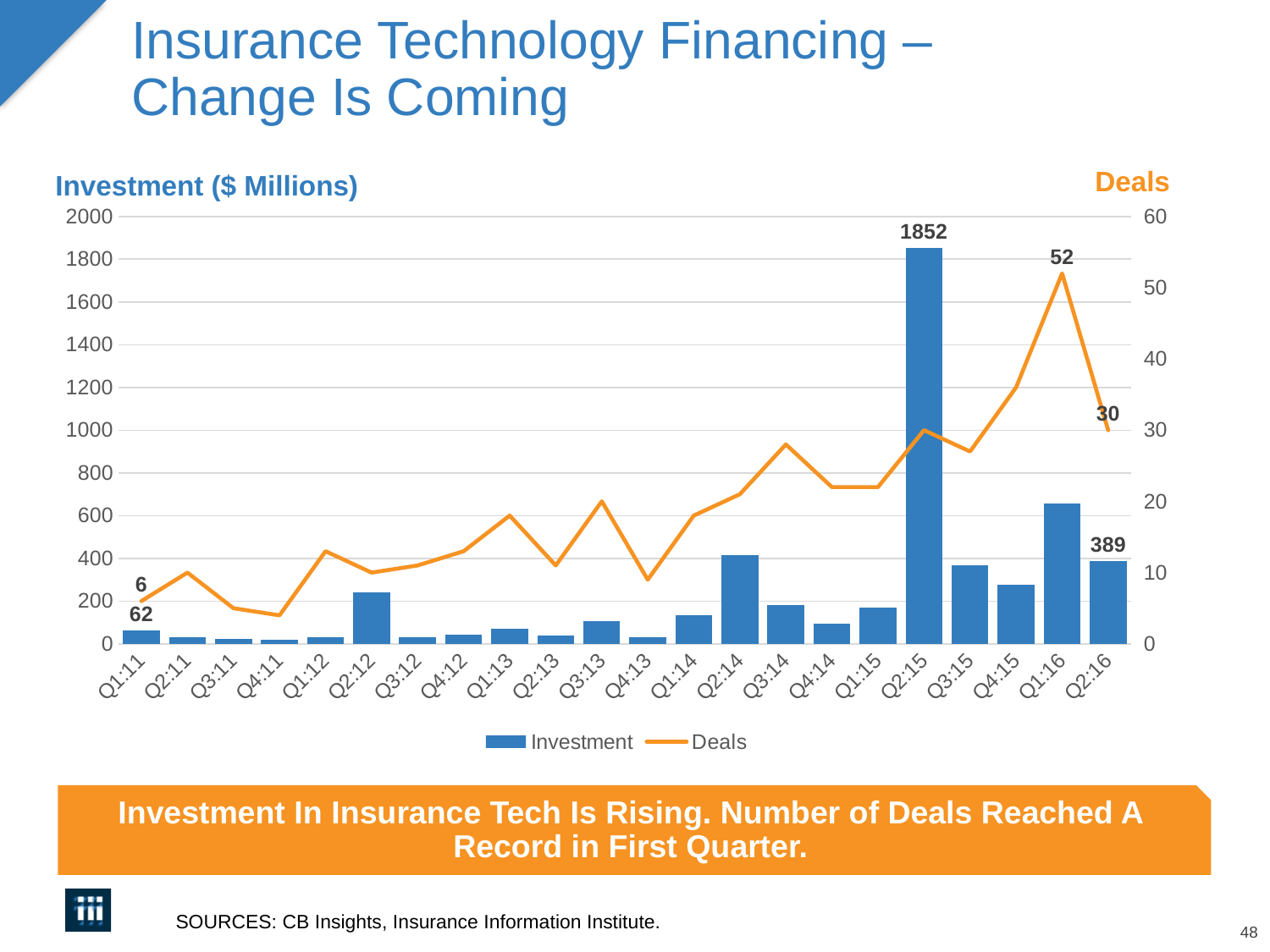
Which quarter has the highest number of Deals? Q1:16 What is the Investment value for Q1:11? 62 Is the Investment value for Q1:16 greater or less than 400? greater What is the difference between the Investment values for Q2:15 and Q2:16? 1463 By how much did the number of Deals fall from Q1:16 to Q2:16? 22 What kind of chart is shown on the slide? A combination bar and line chart How many Deals are shown for Q1:16? 52 How many Deals are shown for Q2:16? 30 Which quarter has the highest Investment? Q2:15 How many series does the legend list? 2 How many quarters are shown on the x axis? 22 What is the Investment value for Q2:15? 1852